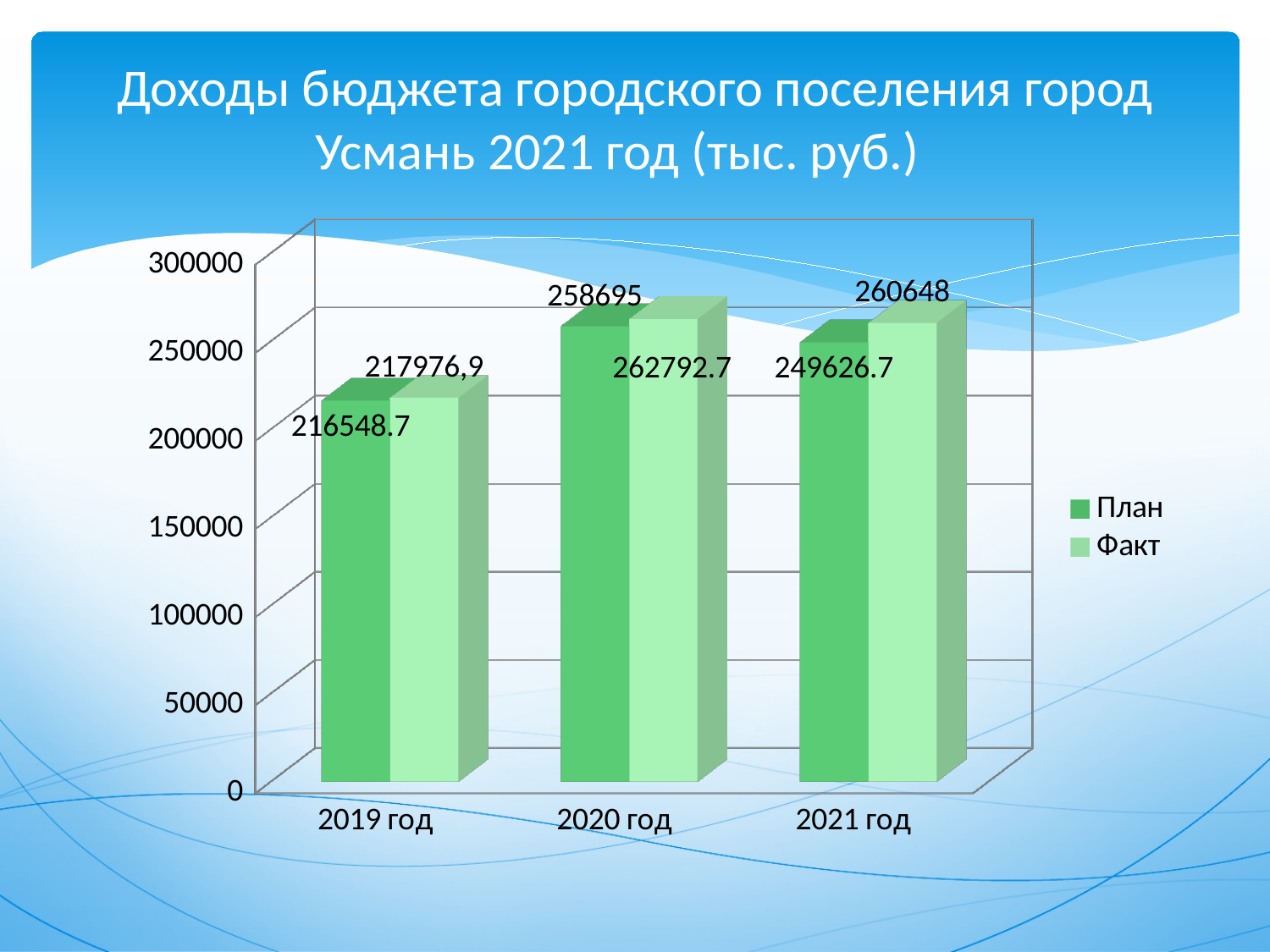
What is the difference between the Факт and План values for 2021 год? 11021.3 How many years are shown on the x axis? 3 What is the План value for 2021 год? 249626.7 Which year has the lowest Факт value? 2019 год Which year has the highest План value? 2020 год What is the Факт value for 2020 год? 262792.7 What kind of chart is shown on the slide? bar chart How many series does the legend list? 2 What is the План value for 2019 год? 216548.7 Which is larger for 2020 год, План or Факт? Факт Is the План value for 2019 год greater or less than 200000? greater What is the Факт value for 2021 год? 260648